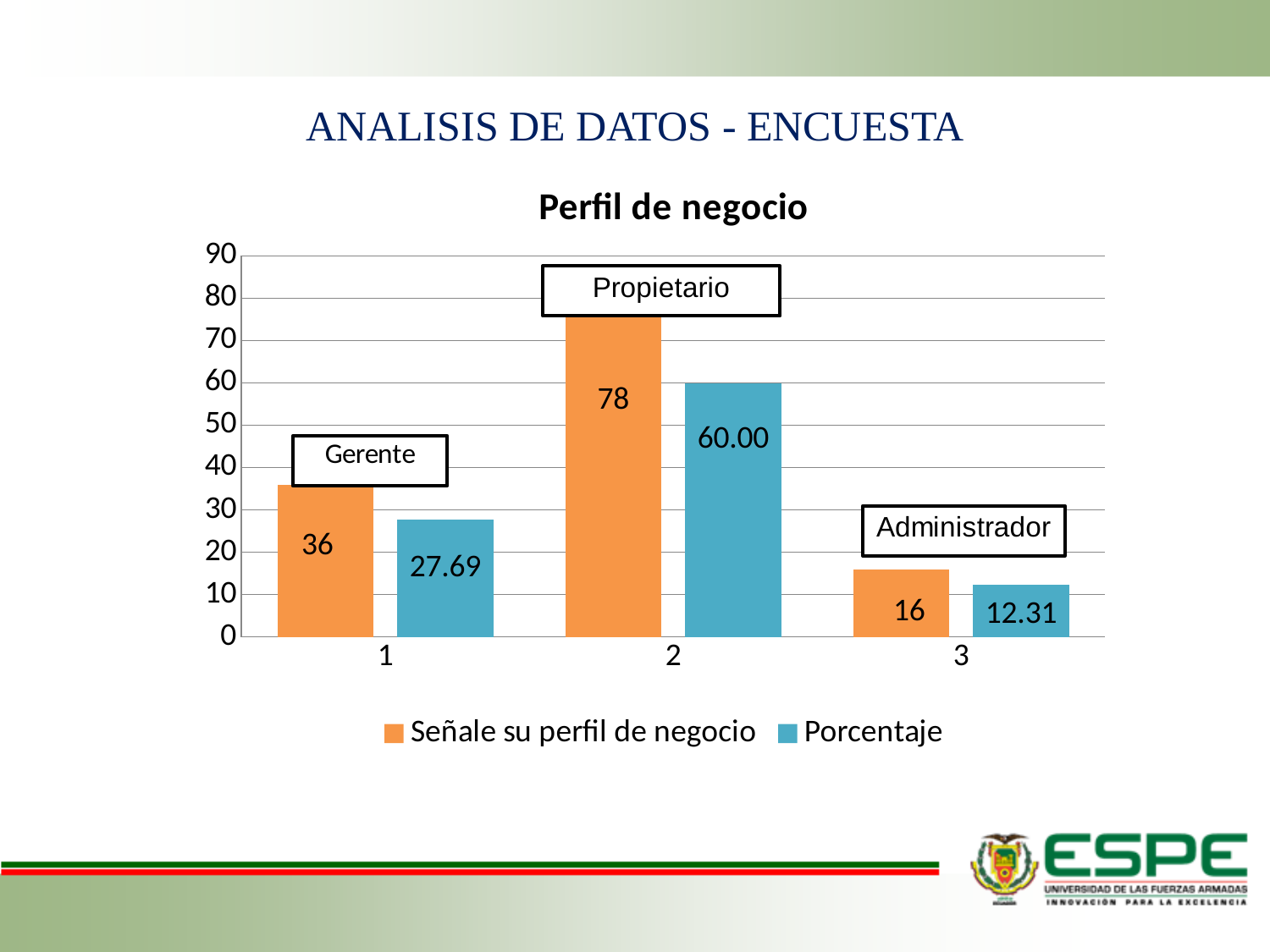
What is the value of 'Señale su perfil de negocio' for category 1 (Gerente)? 36 What is the value of 'Señale su perfil de negocio' for category 2 (Propietario)? 78 What is the difference between the 'Señale su perfil de negocio' values for category 2 and category 1? 42 Which is larger: the 'Porcentaje' value for category 1 or for category 3? Category 1 (27.69) Is the 'Señale su perfil de negocio' value for category 3 greater or less than 20? less Which category has the highest 'Señale su perfil de negocio' value? 2 (Propietario) What is the 'Porcentaje' value for category 1 (Gerente)? 27.69 How many categories are shown on the x axis? 3 What is the 'Porcentaje' value for category 3 (Administrador)? 12.31 What type of chart is shown on the slide? Bar chart Which category has the lowest 'Porcentaje' value? 3 (Administrador) How many series does the legend list? 2